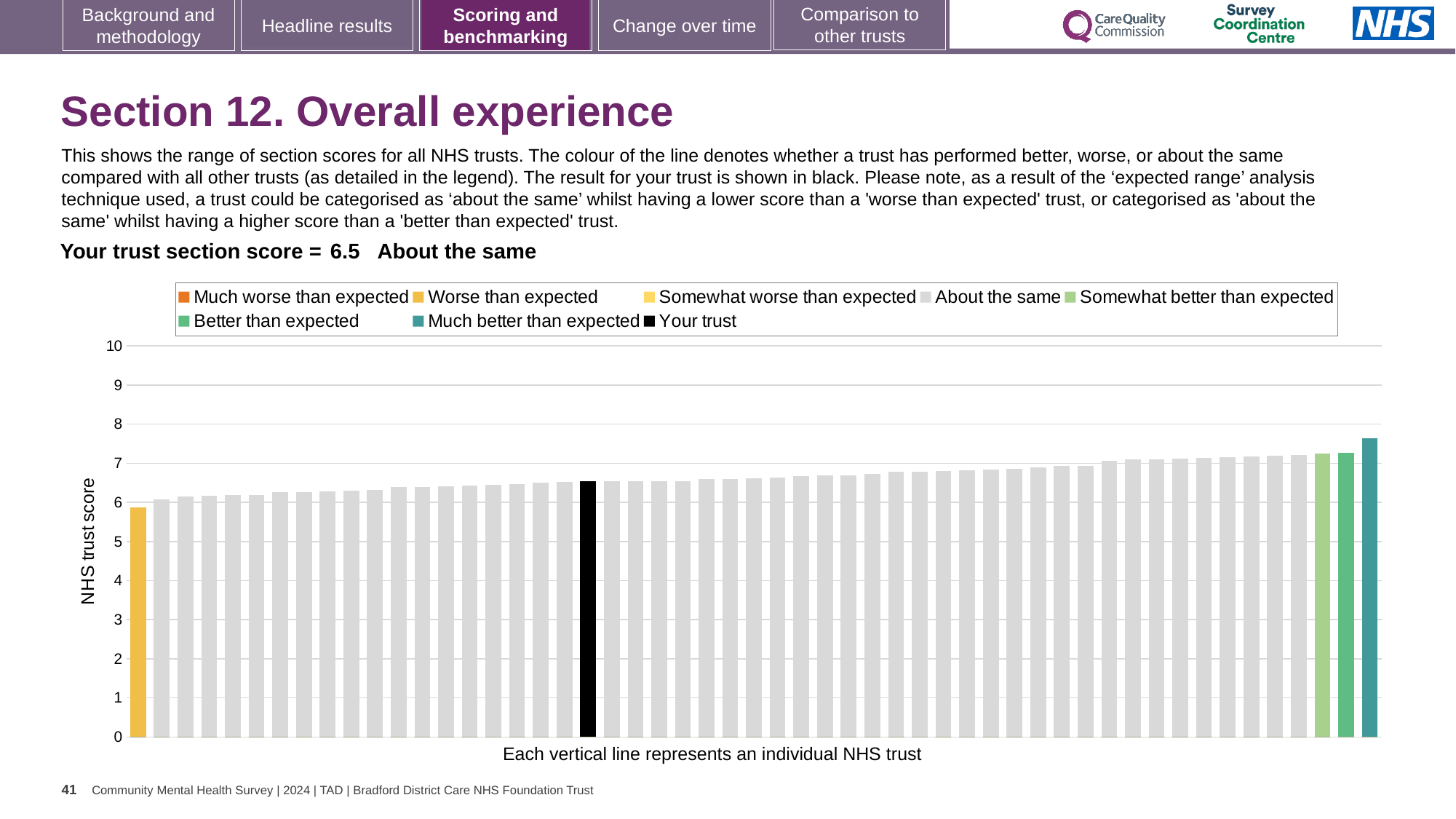
Which performance category is your trust placed in for Section 12? About the same Is the value for your trust (the black bar) greater or less than 6? greater Do the bar values rise or fall from left to right along the x axis? rise Is the value of the highest bar (Much better than expected) greater or less than 7? greater Is the value of the highest bar greater or less than 8? less What kind of chart is shown on the slide? bar chart Which legend category does the lowest bar on the chart belong to? Worse than expected How many bars are coloured as 'Worse than expected'? 1 What is the label on the vertical axis of the chart? NHS trust score How many entries does the chart legend list? 8 What is the section score for your trust shown on the slide? 6.5 Which legend category does the highest bar on the chart belong to? Much better than expected